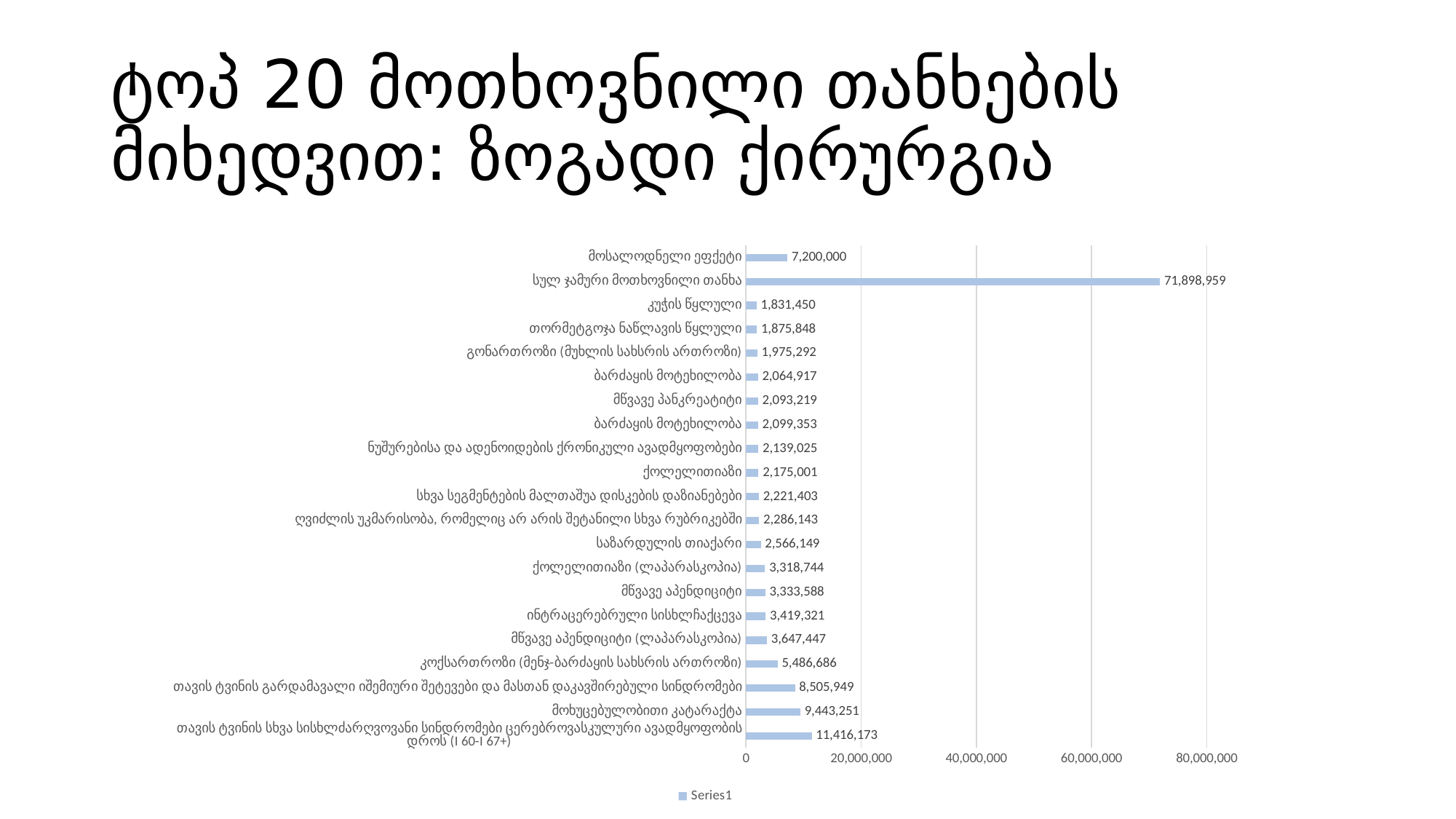
What is the value for მოსალოდნელი ეფექტი? 7,200,000 Which category has the lowest value? კუჭის წყლული How many categories are plotted in the chart? 21 Is the value for სულ ჯამური მოთხოვნილი თანხა greater or less than 60,000,000? greater What is the difference between the values for მოხუცებულობითი კატარაქტა and მოსალოდნელი ეფექტი? 2,243,251 Which category has the highest value? სულ ჯამური მოთხოვნილი თანხა What is the value for სულ ჯამური მოთხოვნილი თანხა? 71,898,959 What is the value for მოხუცებულობითი კატარაქტა? 9,443,251 What is the value for კოქსართროზი (მენჯ-ბარძაყის სახსრის ართროზი)? 5,486,686 What is the name of the series shown in the legend? Series1 Which is larger: the value for მწვავე აპენდიციტი (ლაპარასკოპია) or the value for ინტრაცერებრული სისხლჩაქცევა? მწვავე აპენდიციტი (ლაპარასკოპია) What type of chart is shown on the slide? bar chart